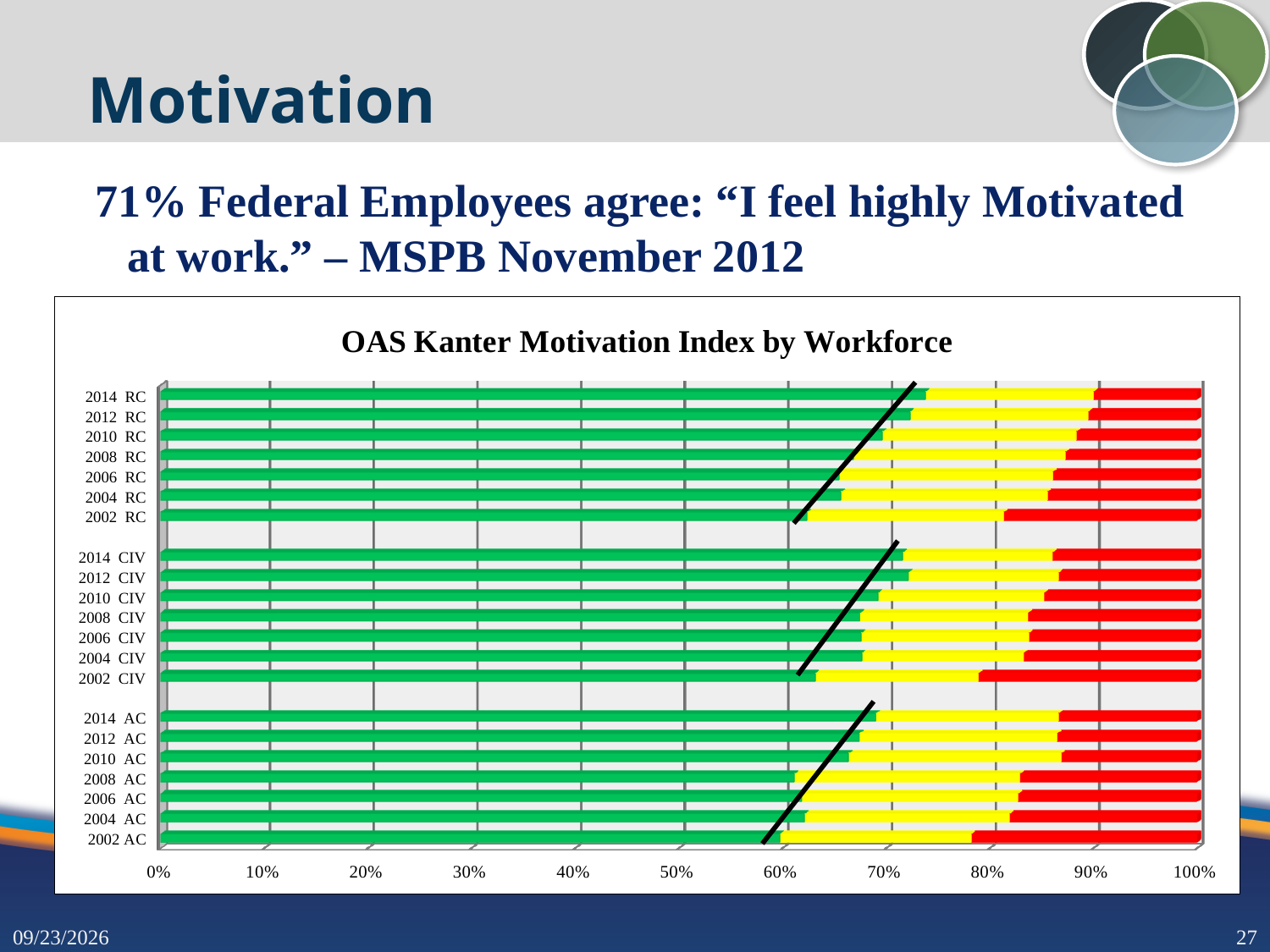
What kind of chart is shown on the slide? stacked bar chart Which bar has the longest green segment? 2014 RC Which has the larger green segment, 2014 RC or 2002 RC? 2014 RC What is the title of the chart? OAS Kanter Motivation Index by Workforce Is the green segment for 2014 RC greater or less than 80%? less Is the green segment for 2014 RC greater or less than 70%? greater How many categories (bars) are plotted in the chart? 21 Within the AC group, does the green segment grow or shrink from 2002 to 2014? grow Which bar has the shortest green segment? 2002 AC Is the green segment for 2002 AC greater or less than 50%? greater Which three workforce groups are shown on the chart's vertical axis? RC, CIV, AC